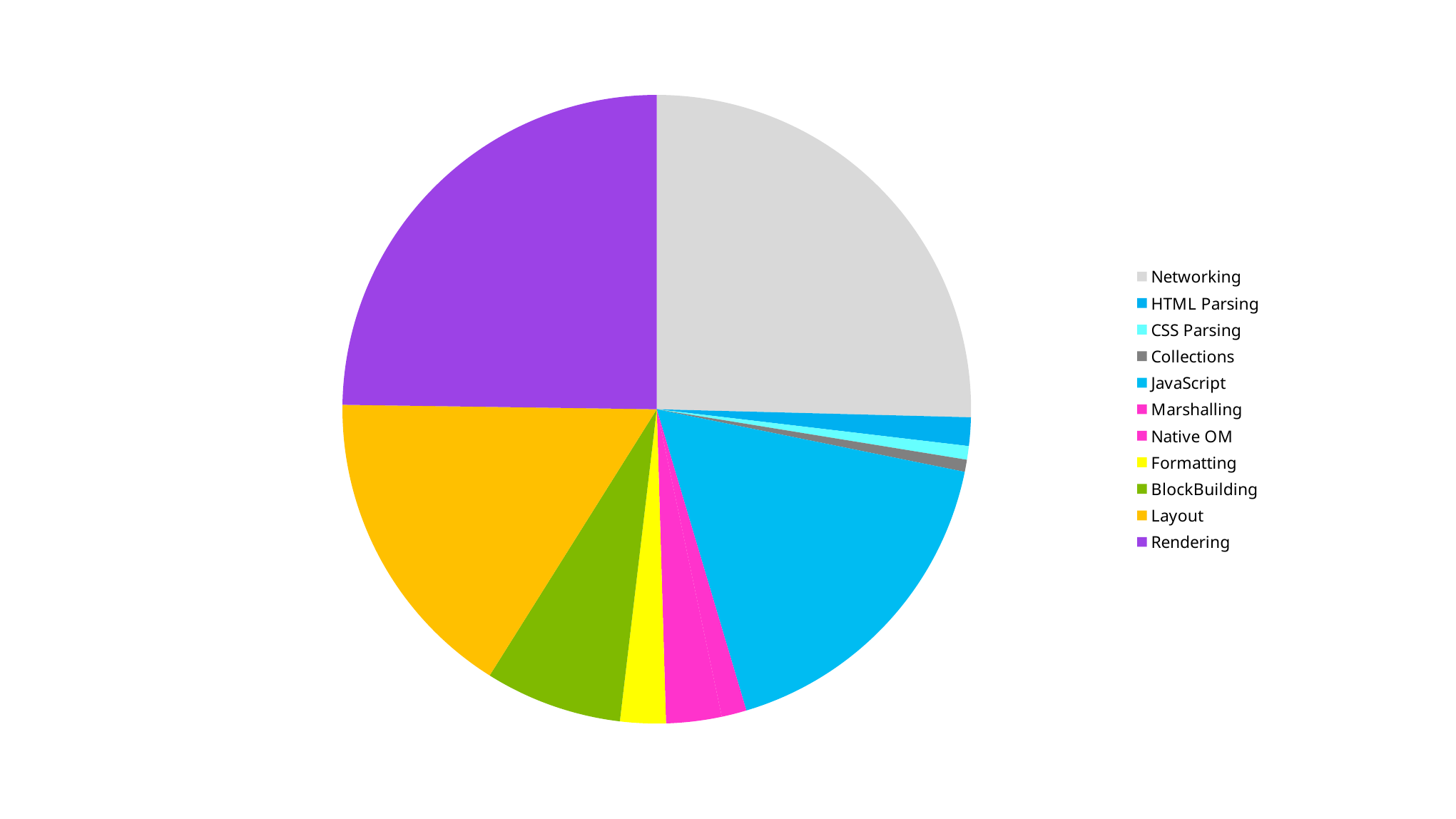
Which is larger in the pie chart, the Networking slice or the HTML Parsing slice? Networking What kind of chart is shown on the slide? pie chart How many categories does the pie chart's legend list? 11 What colour is the Rendering slice in the pie chart? purple Which is larger in the pie chart, the Layout slice or the CSS Parsing slice? Layout Which is larger in the pie chart, the JavaScript slice or the Formatting slice? JavaScript Which category is listed first in the pie chart's legend? Networking